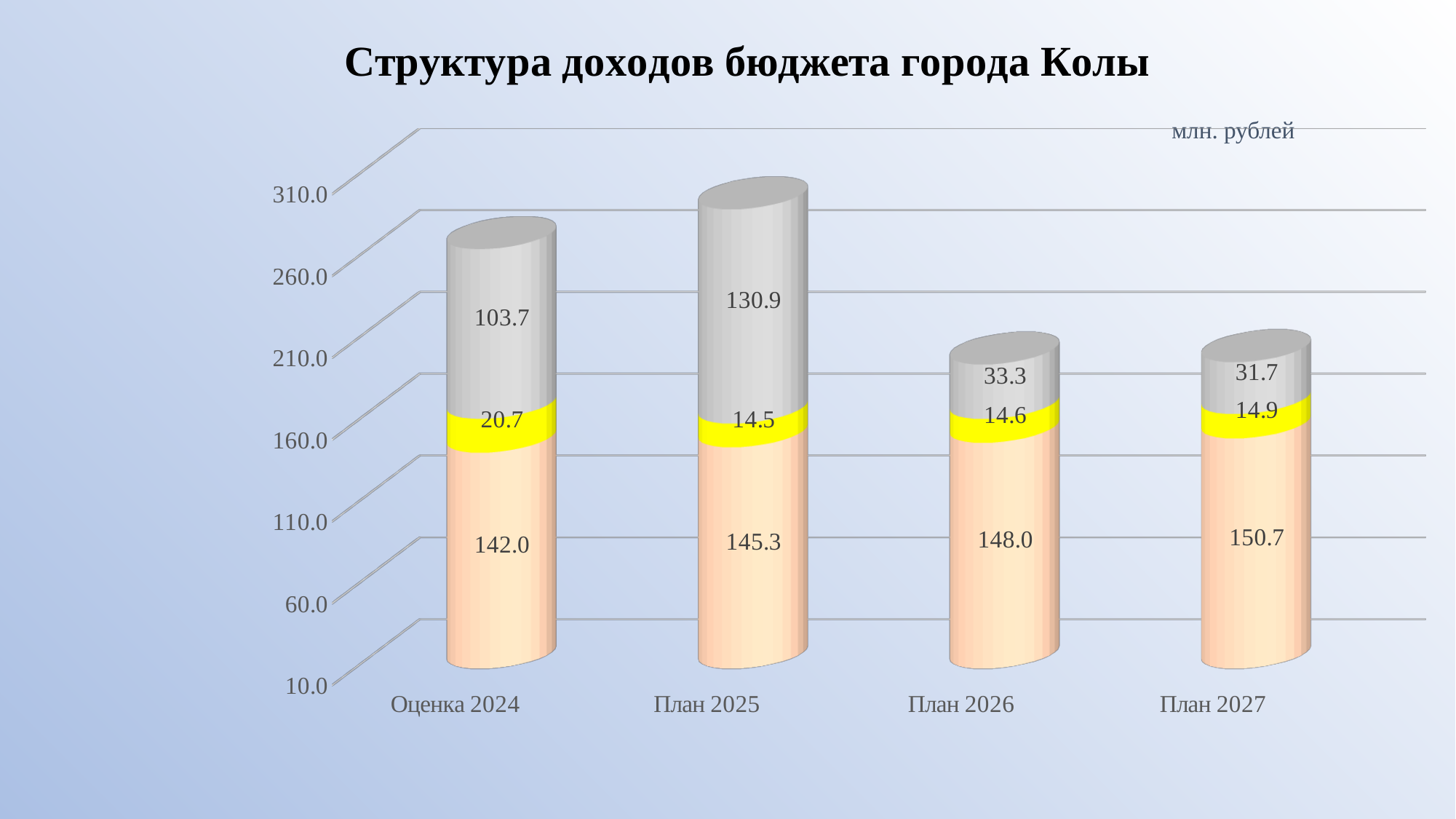
Which is larger: the middle (yellow) segment for Оценка 2024 or for План 2026? Оценка 2024 Which category has the highest value for the top (grey) segment? План 2025 What type of chart is shown on the slide? stacked bar chart Which category has the lowest value for the bottom (peach) segment? Оценка 2024 What is the difference between the top (grey) segment values for План 2025 and План 2026? 97.6 What is the title of the chart? Структура доходов бюджета города Колы What is the value of the bottom (peach) segment for План 2025? 145.3 What is the value of the middle (yellow) segment for План 2027? 14.9 What is the value of the top (grey) segment for Оценка 2024? 103.7 What is the total of the stacked bar for План 2027? 197.3 Do the values of the bottom (peach) segment rise or fall from Оценка 2024 to План 2027? rise How many categories are shown on the x axis? 4